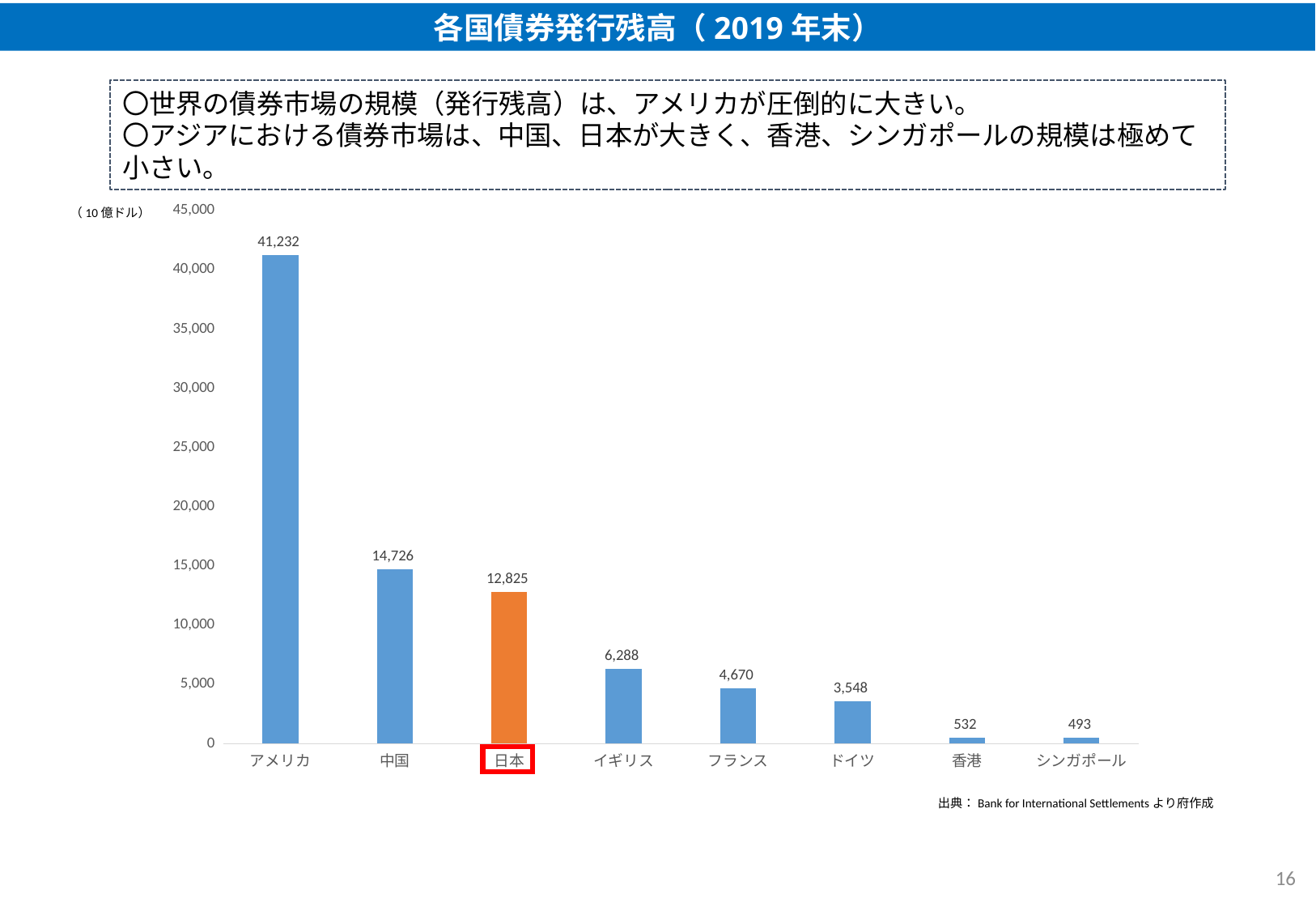
Which is larger, the value for イギリス or the value for フランス? イギリス What is the value for 日本? 12,825 Which country's bar is coloured orange instead of blue? 日本 What is the value for アメリカ? 41,232 Which country has the lowest value? シンガポール Is the value for ドイツ greater or less than 5,000? less Do the values rise or fall from left to right along the x axis? fall What is the difference between the values for 中国 and 日本? 1,901 How many countries are shown on the chart? 8 What is the value for 香港? 532 What kind of chart is shown? bar chart Which country has the highest value? アメリカ